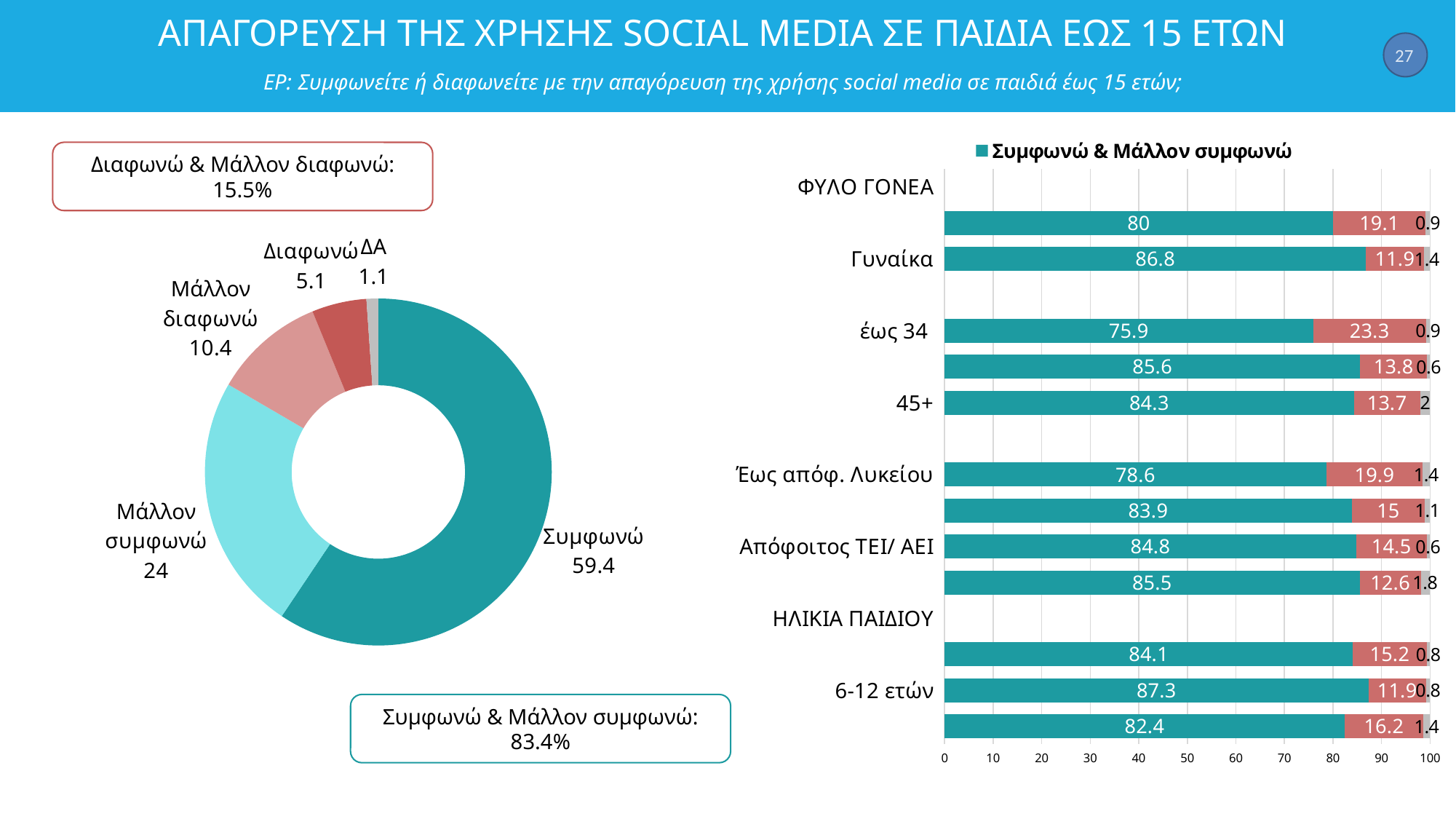
In the bar chart on the right, what is the value of the teal (Συμφωνώ & Μάλλον συμφωνώ) segment for Γυναίκα? 86.8 What kind of chart is the chart on the left of the slide? Donut (pie) chart In the bar chart on the right, is the teal segment value for έως 34 greater or less than 80? less How many categories does the donut chart on the left show? 5 How many series does the legend of the bar chart on the right list? 1 In the bar chart on the right, which has a larger teal segment: 6-12 ετών or Έως απόφ. Λυκείου? 6-12 ετών In the donut chart on the left, what is the value for Συμφωνώ? 59.4 In the donut chart on the left, which category has the largest share? Συμφωνώ In the donut chart on the left, what is the difference between Μάλλον συμφωνώ and Μάλλον διαφωνώ? 13.6 In the bar chart on the right, what is the difference between the teal segment values for Γυναίκα and έως 34? 10.9 In the donut chart on the left, which category has the smallest share? ΔΑ In the bar chart on the right, what is the value of the teal segment for έως 34? 75.9